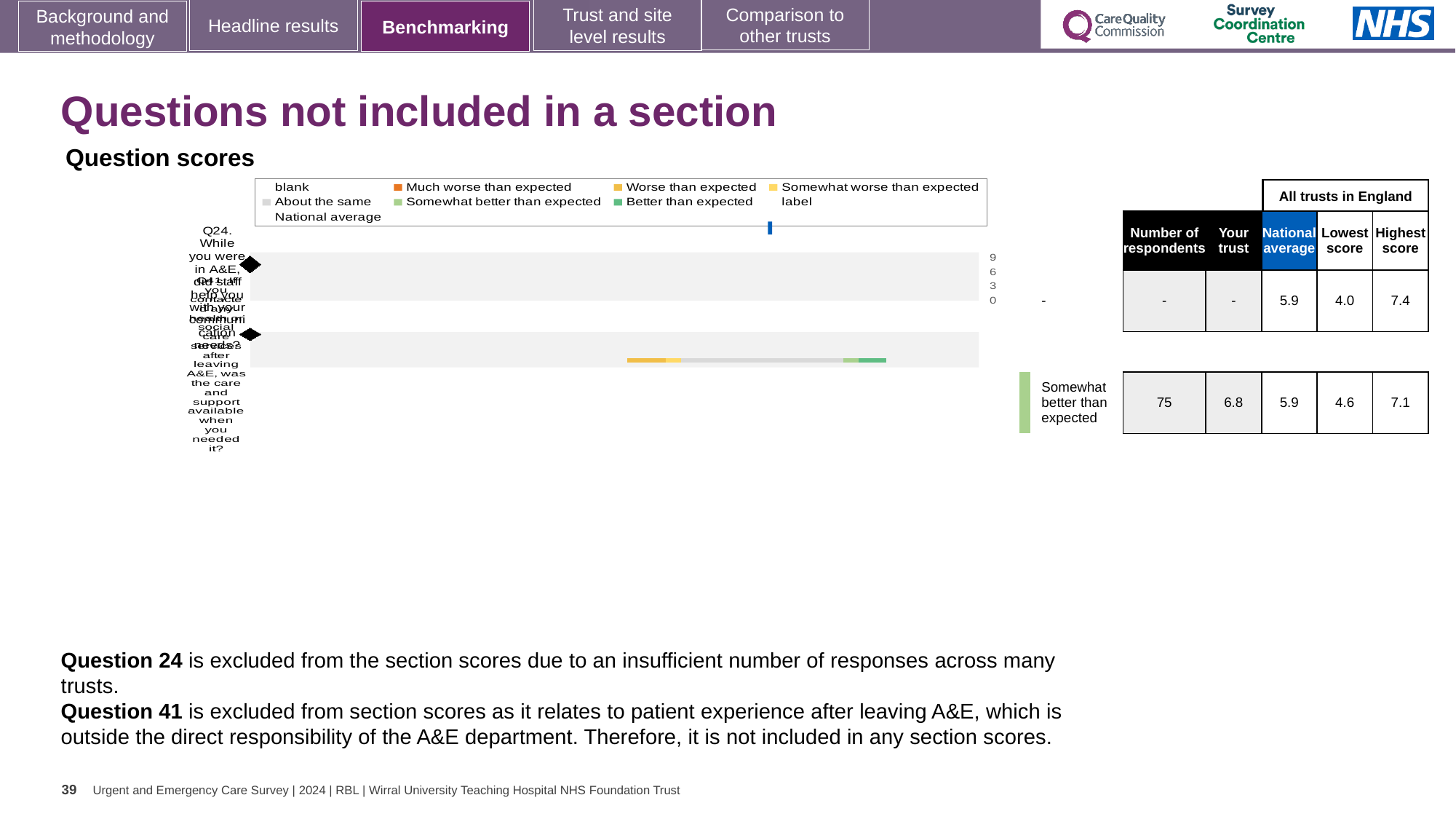
What is the lowest score among all trusts in England for Q24? 4.0 What is the difference between the highest and lowest scores among all trusts in England for the question about care and support after leaving A&E? 2.5 What rating label is shown to the right of the lower bar (the question about care and support after leaving A&E)? Somewhat better than expected What is the 'Your trust' score for the question about care and support available after leaving A&E? 6.8 What is the number of respondents for the question about care and support available after leaving A&E? 75 Which colour does the legend use for 'Much worse than expected'? orange What is the highest score among all trusts in England for the question about care and support available after leaving A&E? 7.1 For the question about care and support after leaving A&E, what is the difference between the 'Your trust' score and the national average? 0.9 What is the highest tick value shown on the score axis of the chart? 9 What kind of chart is shown under 'Question scores'? bar chart What is the national average score for the question about care and support available after leaving A&E? 5.9 For the question about care and support after leaving A&E, which is larger: the 'Your trust' score or the national average? Your trust